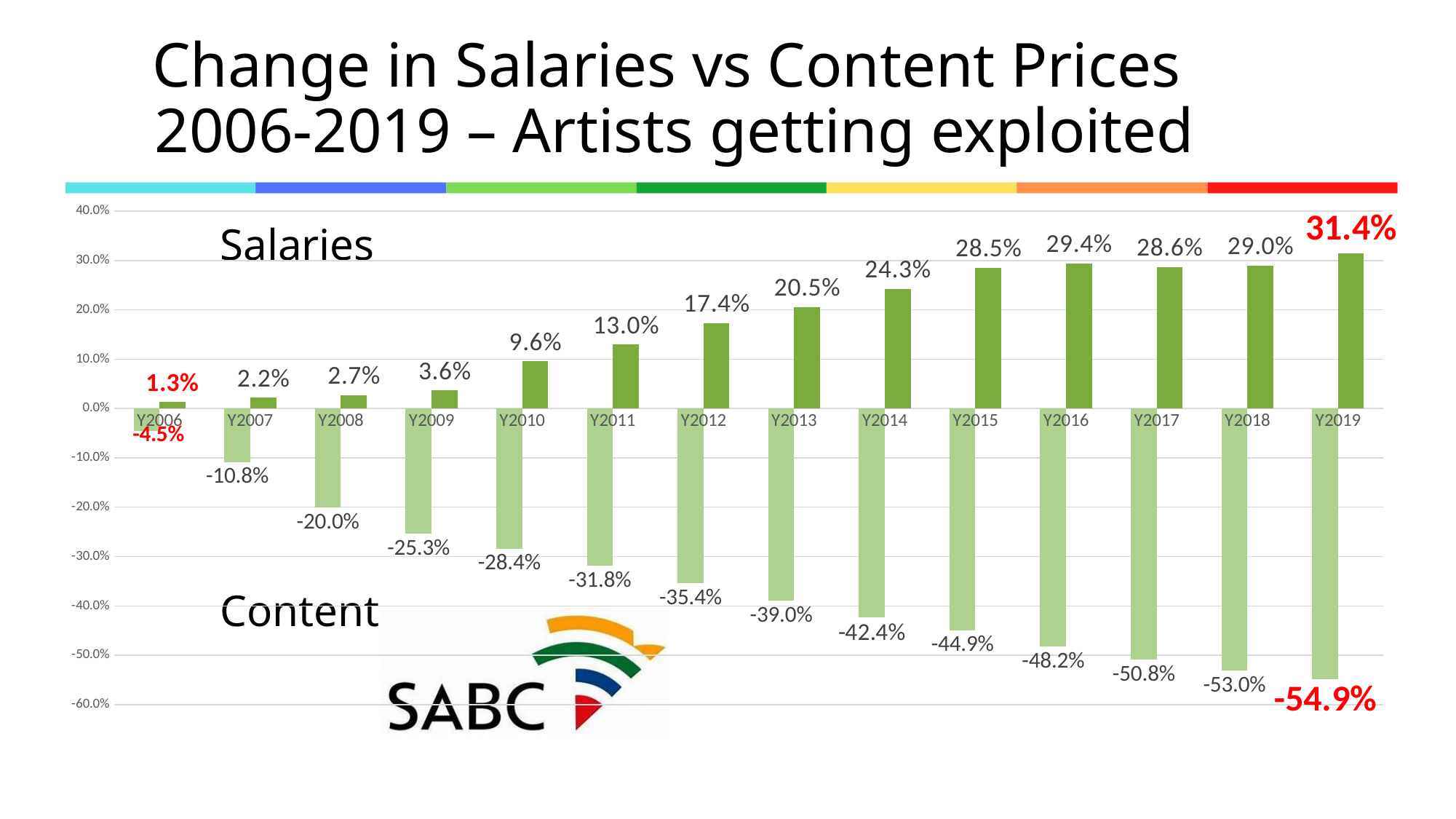
What is the difference between the Salaries values for Y2016 and Y2015? 0.9% What is the Salaries value for Y2019? 31.4% What is the Salaries value for Y2010? 9.6% What is the Content value for Y2006? -4.5% What kind of chart is shown on the slide? Bar chart Do the Content values rise or fall from Y2006 to Y2019? Fall What is the title of the slide? Change in Salaries vs Content Prices 2006-2019 – Artists getting exploited Which year has the highest Salaries value? Y2019 Which is larger, the Salaries value for Y2012 or for Y2013? Y2013 Which year has the lowest Content value? Y2019 How many years are shown on the x axis? 14 What is the Content value for Y2013? -39.0%